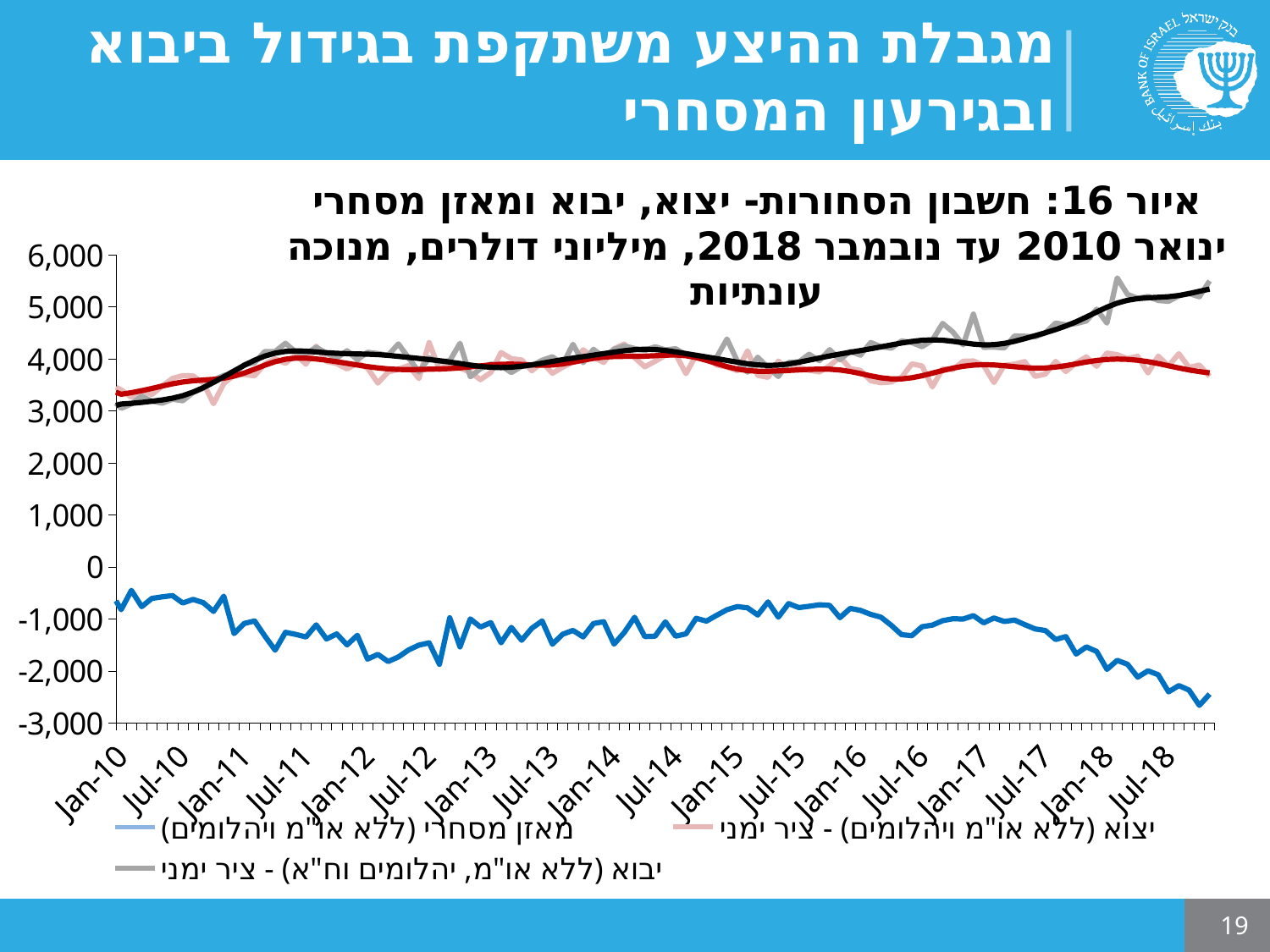
Which series is drawn in blue according to the legend? מאזן מסחרי (ללא או"מ ויהלומים) Does the imports (יבוא) series rise or fall overall from Jan-10 to the end of 2018? rise How many series does the chart legend list? 3 What is the lowest value shown on the vertical axis? -3,000 Is the value of the trade balance (מאזן מסחרי) series at the end of 2018 greater or less than -2,000? less Is the value of the imports (יבוא) series at the end of 2018 greater or less than 5,000? greater Does the trade balance (מאזן מסחרי) series rise or fall overall from Jan-10 to the end of 2018? fall What kind of chart is shown on the slide? line chart What is the figure number given in the chart title? איור 16 Is the value of the exports (יצוא) series at the end of 2018 greater or less than 5,000? less At the end of 2018, which is larger: the imports (יבוא) series or the exports (יצוא) series? imports (יבוא)